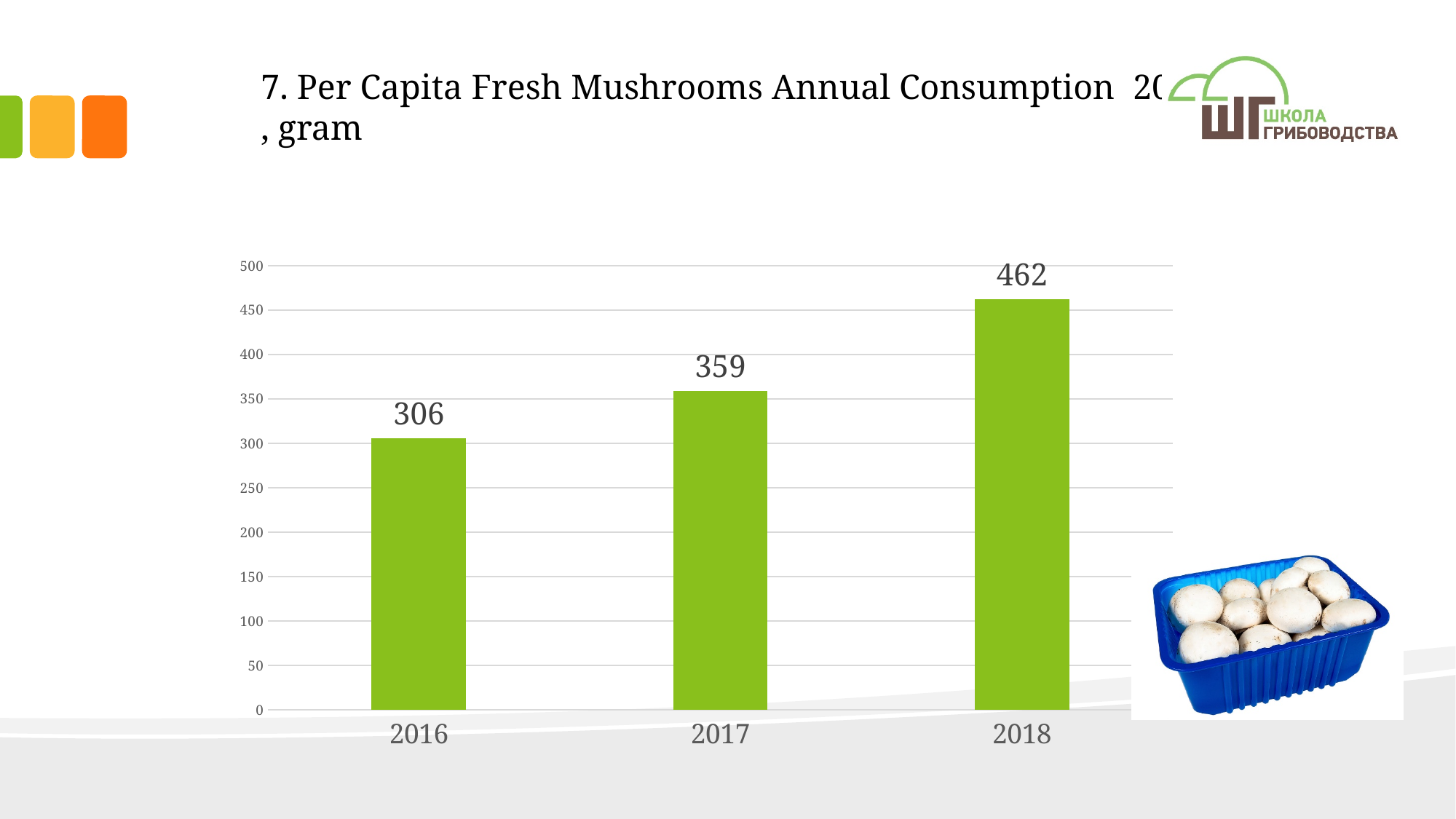
Is the value for 2018 greater or less than 450? greater What kind of chart is shown on the slide? bar chart Which year has the highest value? 2018 Which year has the lowest value? 2016 How many years are shown on the x axis? 3 Which is larger, the value for 2017 or the value for 2018? 2018 What is the per capita fresh mushroom consumption value shown for 2016? 306 What is the value shown for 2018? 462 What is the difference between the 2018 and 2016 values? 156 What is the value shown for 2017? 359 Do the values rise or fall from 2016 to 2018? rise What is the difference between the 2017 and 2016 values? 53